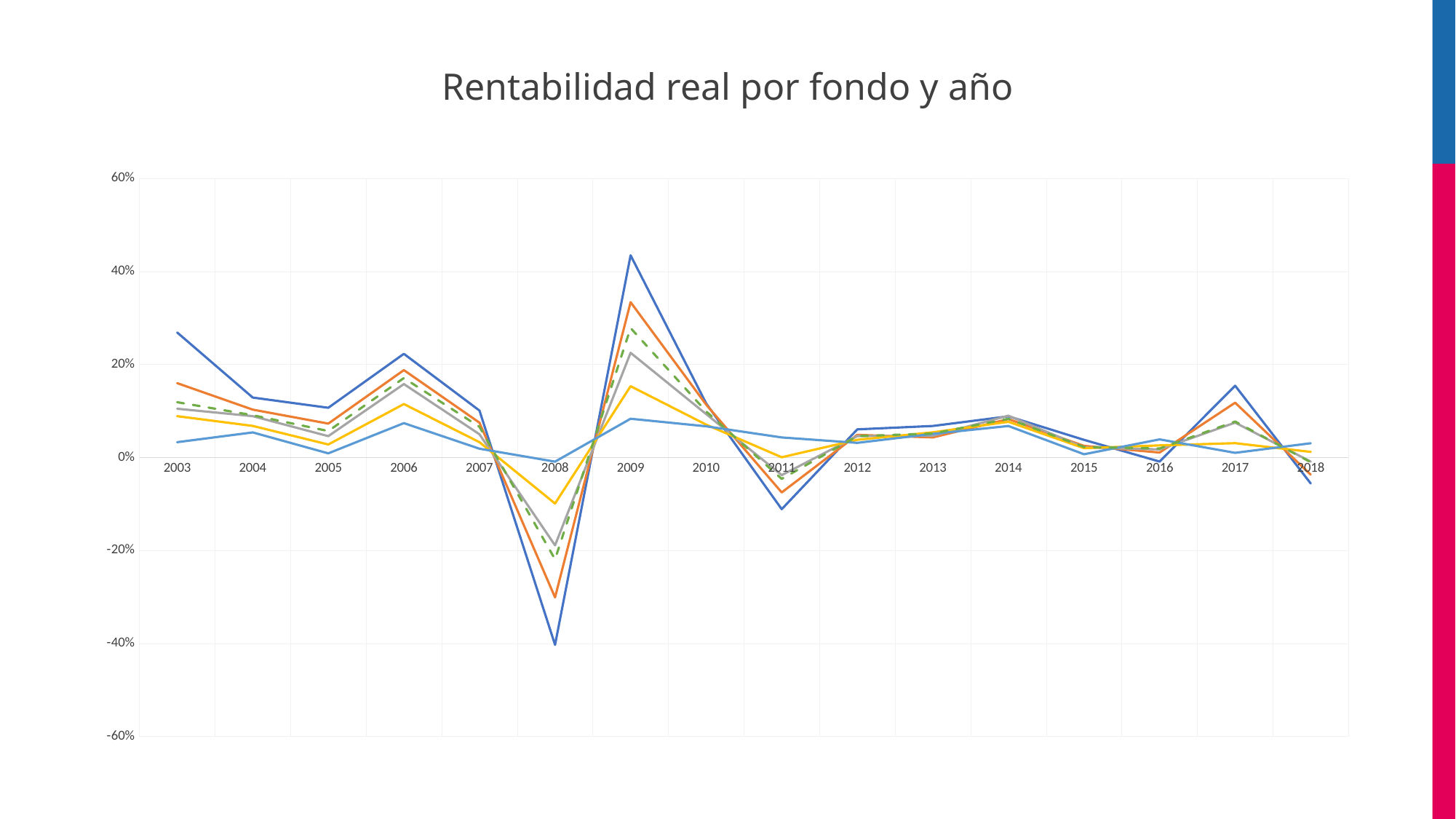
What kind of chart is shown on the slide? line chart In 2009, which line is higher, the dark blue line or the orange line? dark blue line Is the value of the orange line in 2008 greater or less than -20%? less Does the dark blue line rise or fall from 2003 to 2005? fall Is the value of the dark blue line in 2009 greater or less than 40%? greater Is the value of the yellow line in 2008 greater or less than 0%? less In which year does the dark blue line reach its highest value? 2009 In which year does the dark blue line reach its lowest value? 2008 How many years are shown along the x axis? 16 What is the highest value shown on the y axis? 60% What is the title of the chart? Rentabilidad real por fondo y año